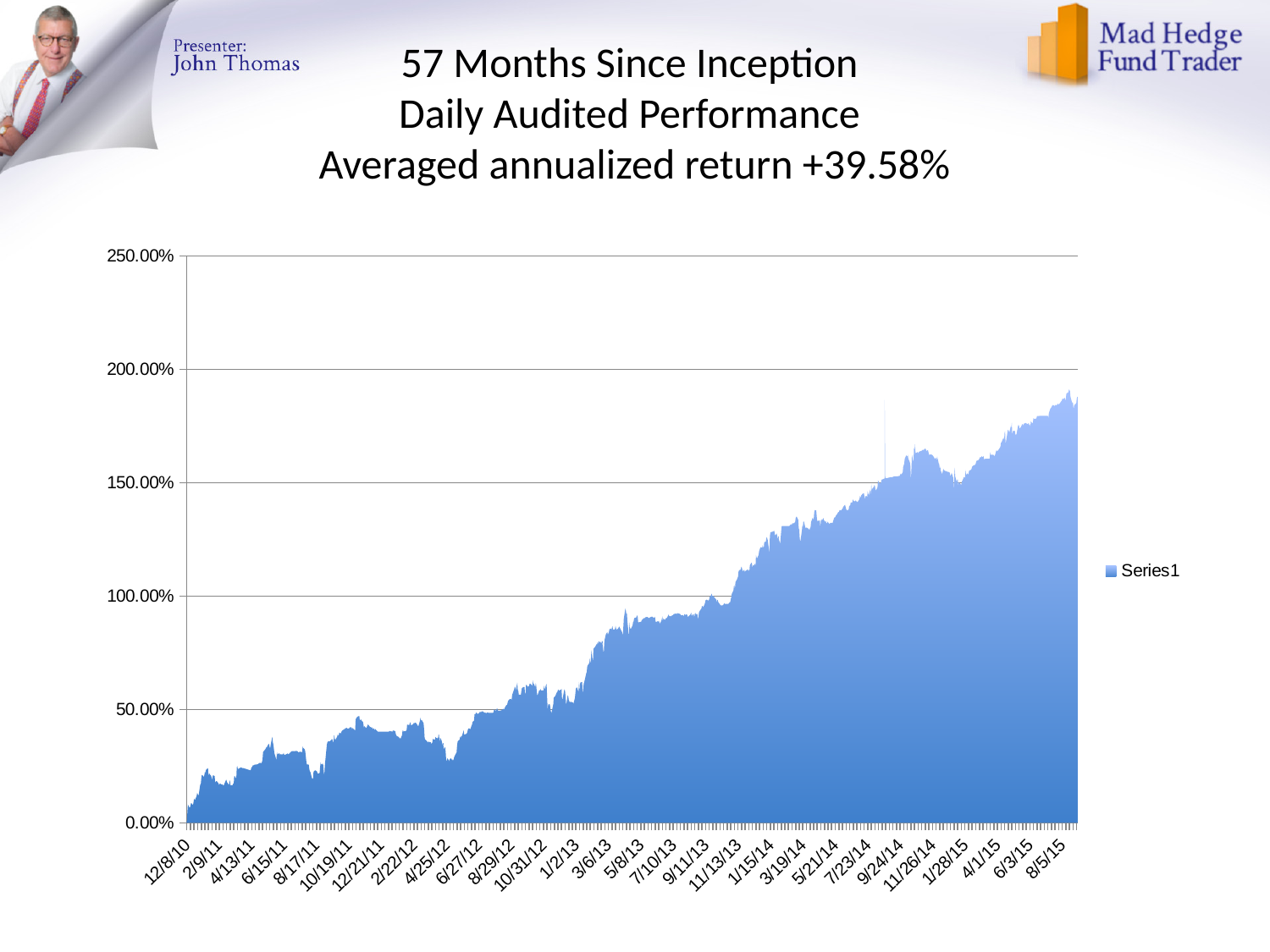
Is the value for 1/2/13 greater or less than 100.00%? less What is the averaged annualized return stated in the chart title? +39.58% Is the value for 7/23/14 greater or less than 100.00%? greater Do the values generally rise or fall from 12/8/10 to 8/5/15? Rise Is the value for 8/5/15 greater or less than 150.00%? greater What is the name of the series shown in the legend? Series1 What kind of chart is shown on the slide? Area chart Which of the two dates has the larger value, 3/6/13 or 1/28/15? 1/28/15 How many series does the legend list? 1